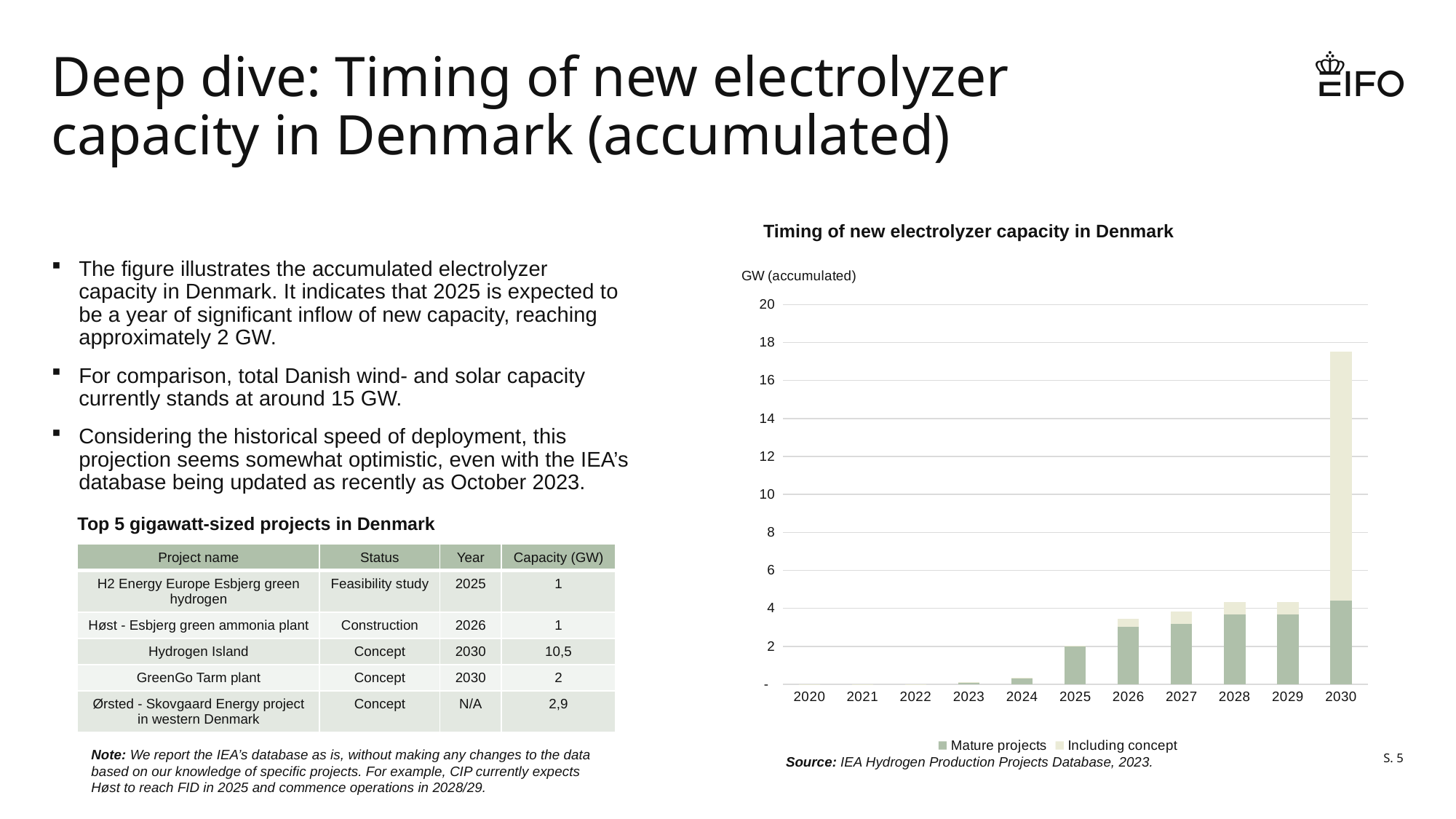
What unit label is shown above the y axis of the chart? GW (accumulated) What are the two series named in the chart's legend? Mature projects; Including concept Is the total bar height for 2028 greater or less than 6? less Is the total bar height for 2030 greater or less than 16? greater How many years are shown on the x axis of the chart? 11 Is the total bar height for 2025 greater or less than 4? less Do the accumulated capacity values rise or fall from 2020 to 2030? rise Which year has the highest total accumulated capacity in the chart? 2030 What kind of chart is shown on the slide? bar chart How many series does the chart's legend list? 2 Which year has a taller total bar, 2025 or 2030? 2030 Which year has a taller total bar, 2024 or 2026? 2026